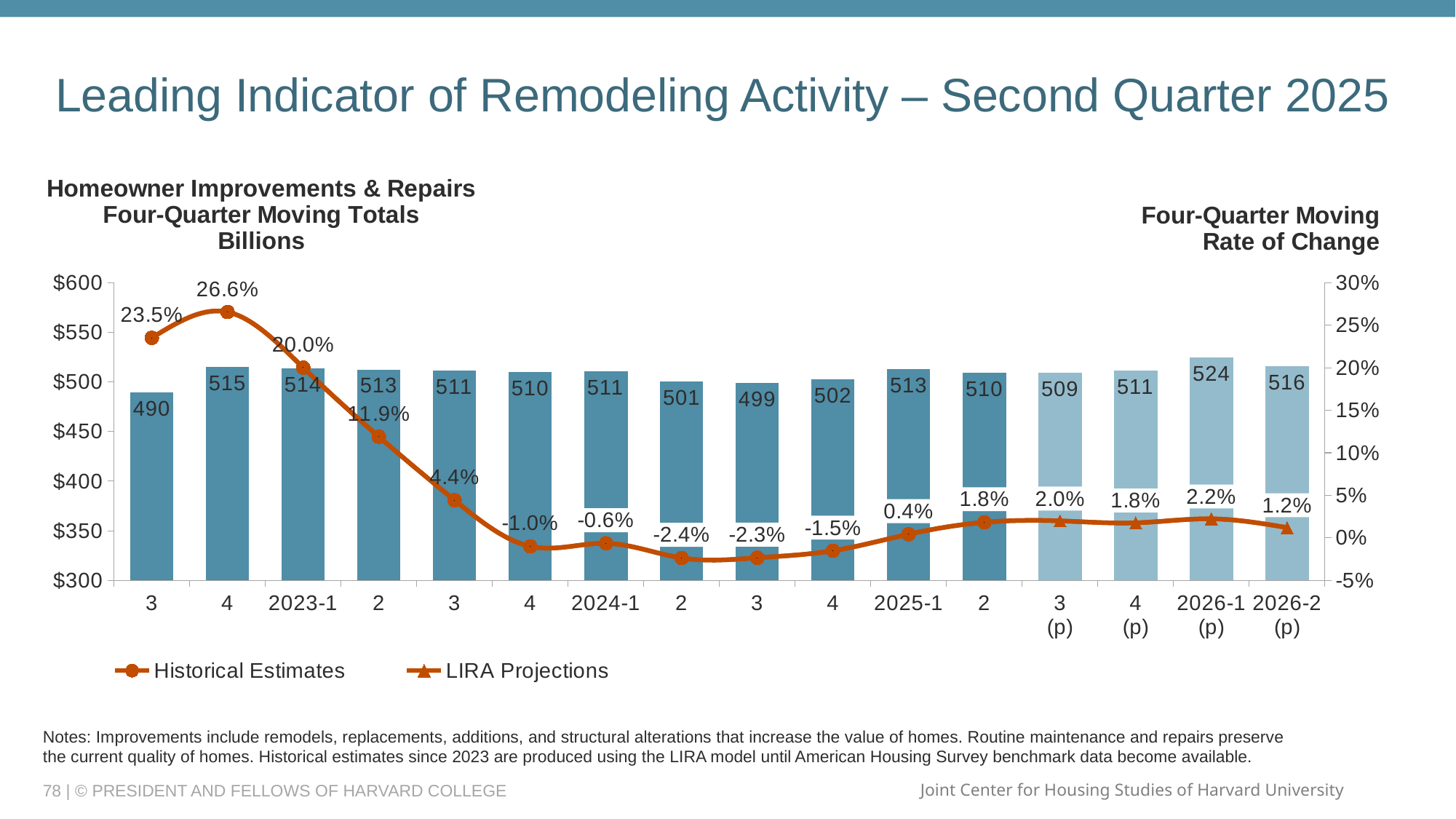
What is the four-quarter moving total for 2025-1? 513 Which is larger, the four-quarter moving total for 2024-3 or for 2024-4? 2024-4 What is the difference between the four-quarter moving totals for 2026-1 (p) and 2026-2 (p)? 8 What kind of chart is shown on the slide? Combined bar and line chart What is the four-quarter moving total for 2026-1 (p)? 524 How many series does the legend list? 2 What is the four-quarter moving rate of change for 2024-2? -2.4% Which quarter has the lowest four-quarter moving total bar? 3 (the first quarter shown) Does the four-quarter moving rate of change rise or fall from quarter 4 (26.6%) to 2024-2? Fall How many quarters (bars) are plotted on the chart? 16 What is the highest four-quarter moving rate of change shown on the line? 26.6% Which quarter has the highest four-quarter moving total bar? 2026-1 (p)